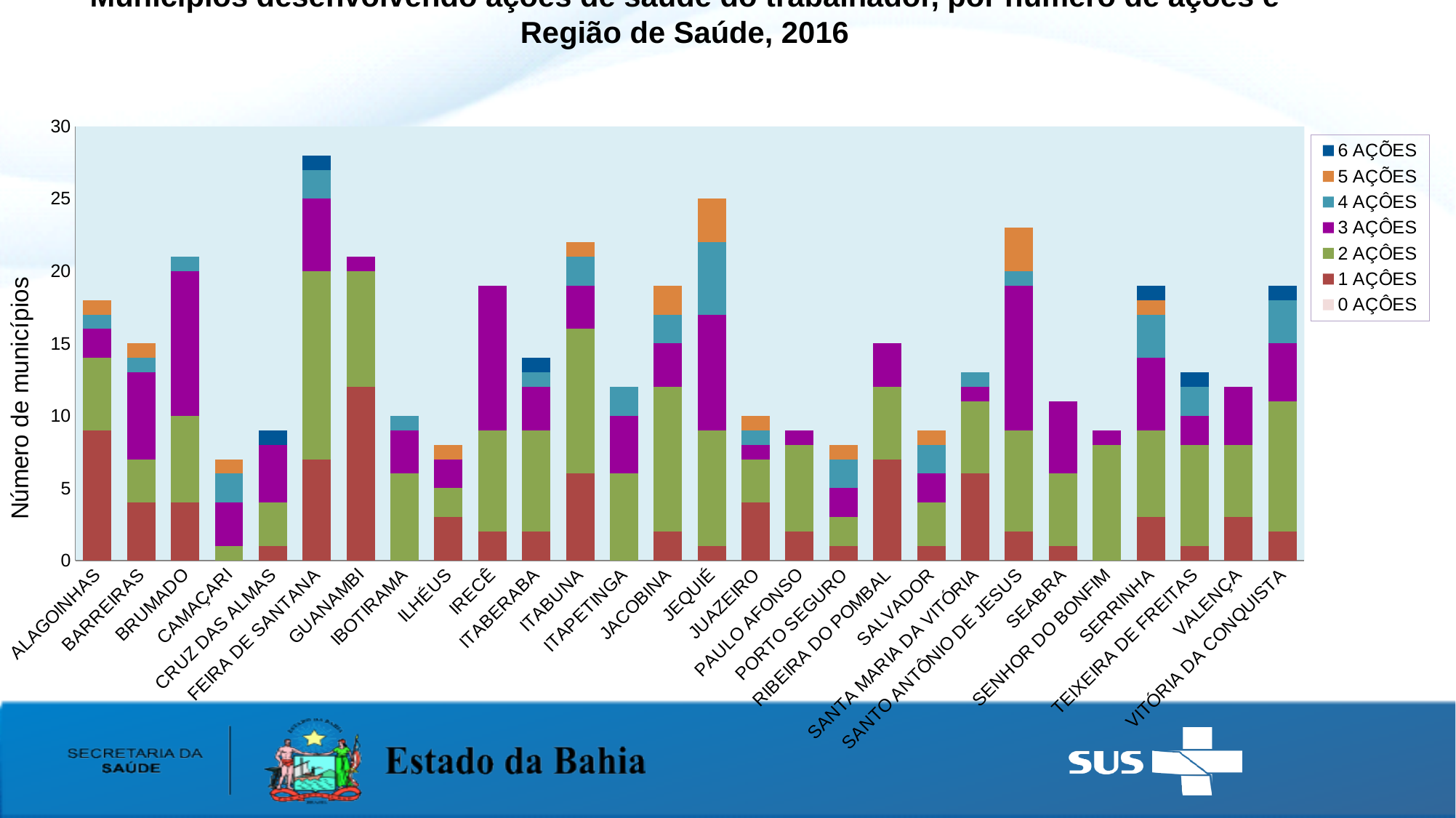
Is the total bar height for CAMAÇARI greater or less than 10? less Is the total bar height for PAULO AFONSO greater or less than 10? less Which has the taller stacked bar, BRUMADO or CRUZ DAS ALMAS? BRUMADO Which has the taller stacked bar, GUANAMBI or IBOTIRAMA? GUANAMBI Which Região de Saúde has the shortest stacked bar? CAMAÇARI Is the total bar height for FEIRA DE SANTANA greater or less than 25? greater What kind of chart is shown on the slide? Stacked bar chart Which Região de Saúde has the tallest stacked bar? FEIRA DE SANTANA What is the label of the y axis? Número de municípios How many series does the legend list? 7 How many Regiões de Saúde (categories) are shown on the x axis? 28